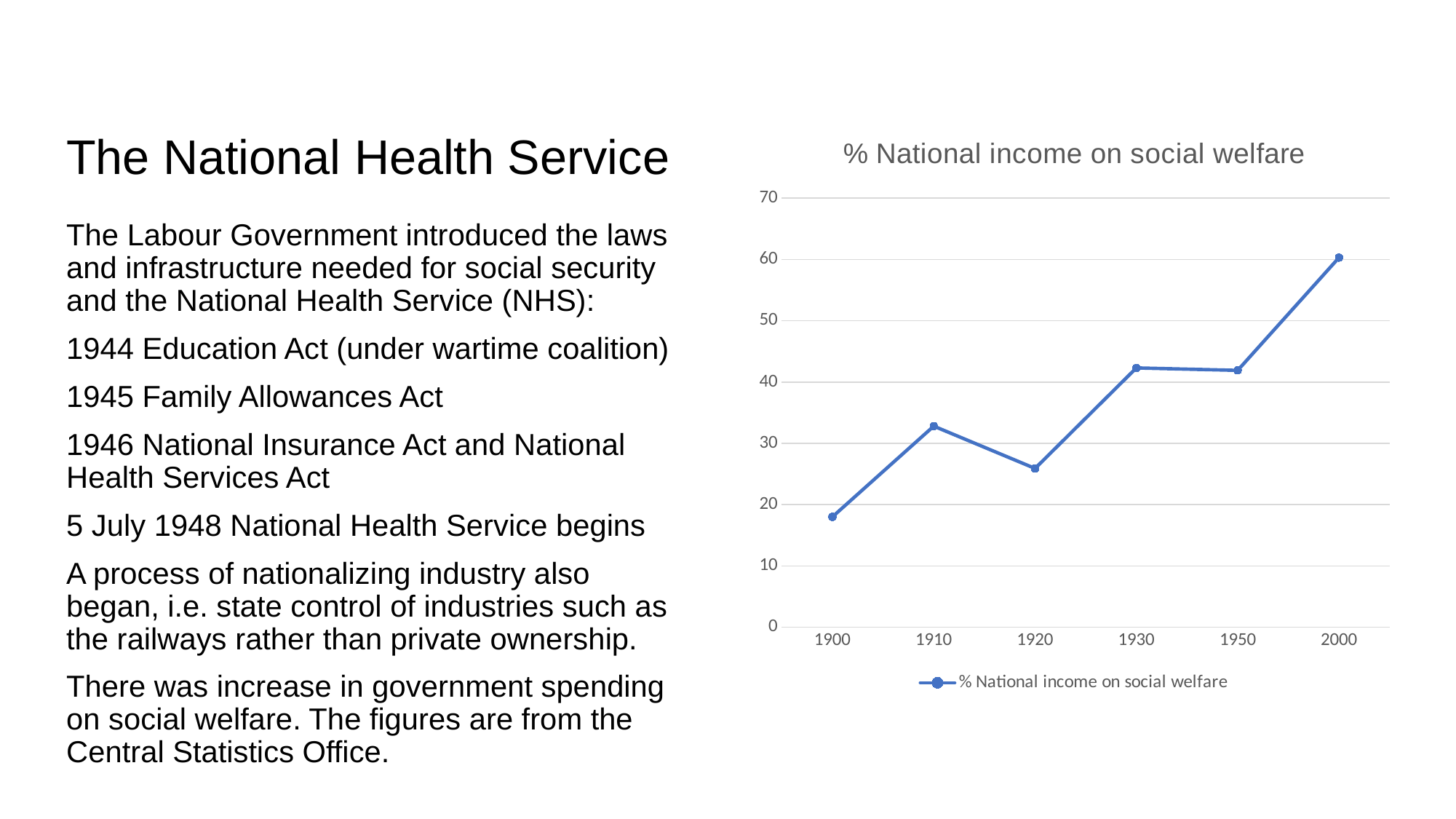
How many data points are plotted on the chart? 6 What is the title of the chart? % National income on social welfare Is the value for 1900 greater or less than 20? less Which year has the lowest value on the chart? 1900 Is the value for 1920 greater or less than 30? less Which year has the highest value on the chart? 2000 Is the value for 1910 greater or less than 30? greater What kind of chart is shown on the slide? line chart How many series does the legend list? 1 Which is larger, the value for 1910 or the value for 1920? 1910 Overall, do the values rise or fall from 1900 to 2000? rise